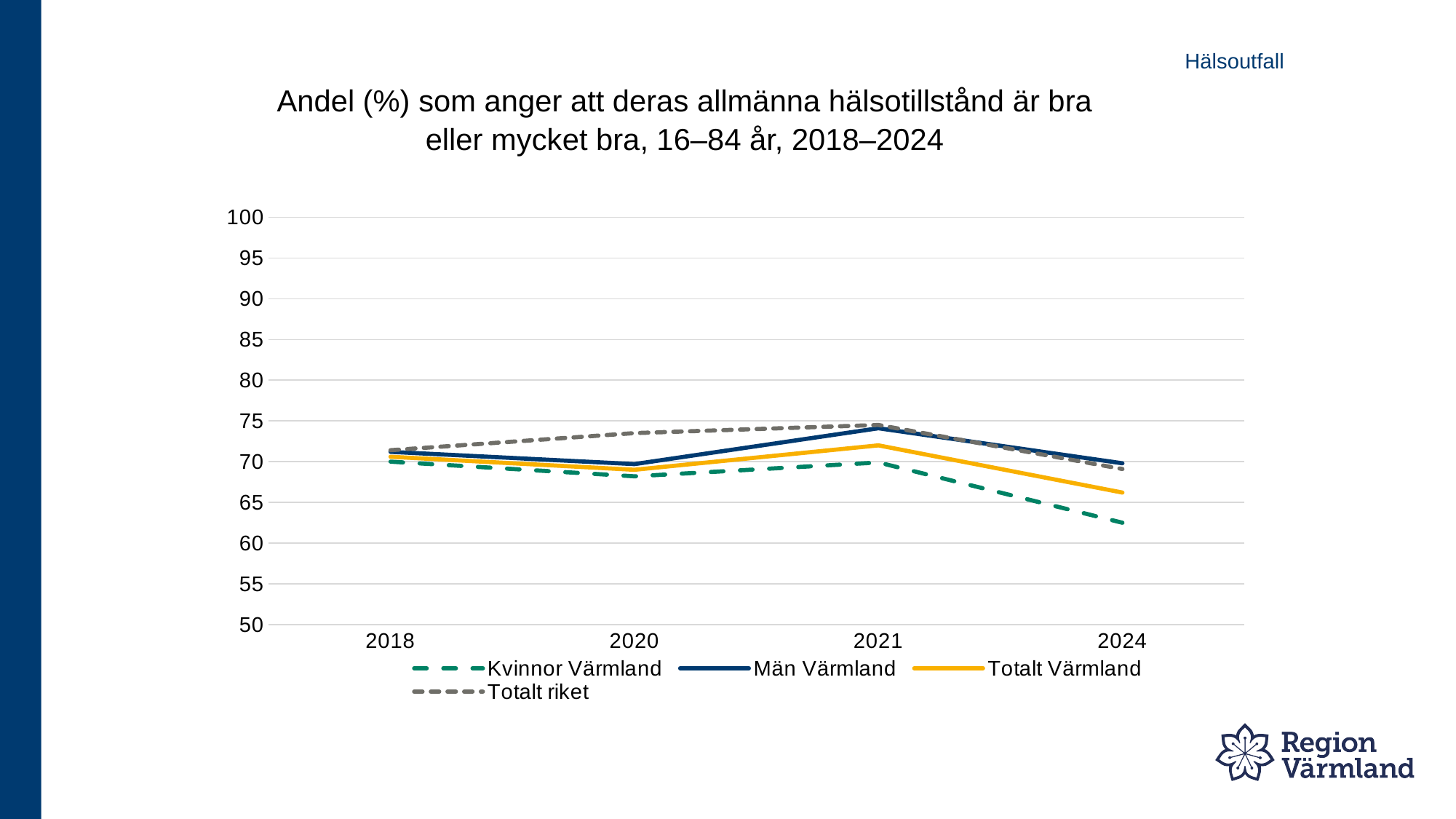
In 2024, which is larger: Män Värmland or Kvinnor Värmland? Män Värmland Does the Totalt riket line rise or fall from 2018 to 2021? Rise Which series is drawn as a yellow solid line? Totalt Värmland How many years are plotted along the x axis? 4 Does the Kvinnor Värmland line rise or fall from 2021 to 2024? Fall What kind of chart is shown on the slide? Line chart Is the value for Totalt Värmland in 2024 greater or less than 65? greater Which series has the lowest value in 2024? Kvinnor Värmland How many series does the legend list? 4 Is the value for Män Värmland in 2021 greater or less than 75? less Is the value for Kvinnor Värmland in 2024 greater or less than 65? less